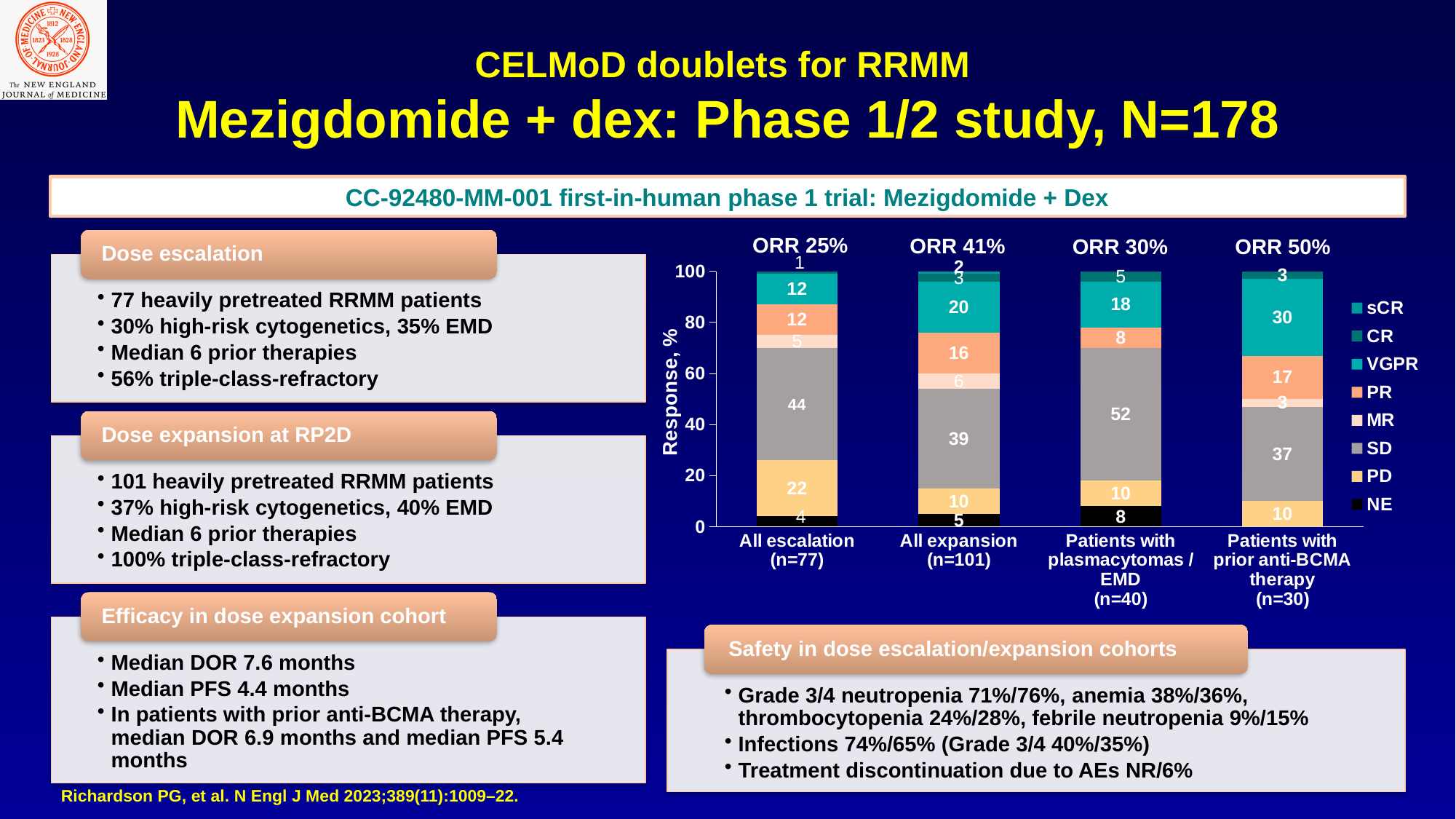
What is the SD value for the All escalation (n=77) group? 44 What is the label on the y axis of the chart? Response, % What is the VGPR value for the Patients with prior anti-BCMA therapy (n=30) group? 30 What kind of chart is shown on the slide? stacked bar chart How many response categories does the chart legend list? 8 What is the difference between the SD value for Patients with plasmacytomas / EMD (n=40) and the SD value for All expansion (n=101)? 13 Which group has the lowest ORR shown above its bar? All escalation (n=77) What is the ORR shown above the Patients with plasmacytomas / EMD (n=40) bar? ORR 30% Which is larger: the PD value for All escalation (n=77) or the PD value for All expansion (n=101)? All escalation (n=77) Which group has the highest ORR shown above its bar? Patients with prior anti-BCMA therapy (n=30) What is the PR value for the All expansion (n=101) group? 16 How many patient groups (bars) are shown on the x axis of the chart? 4